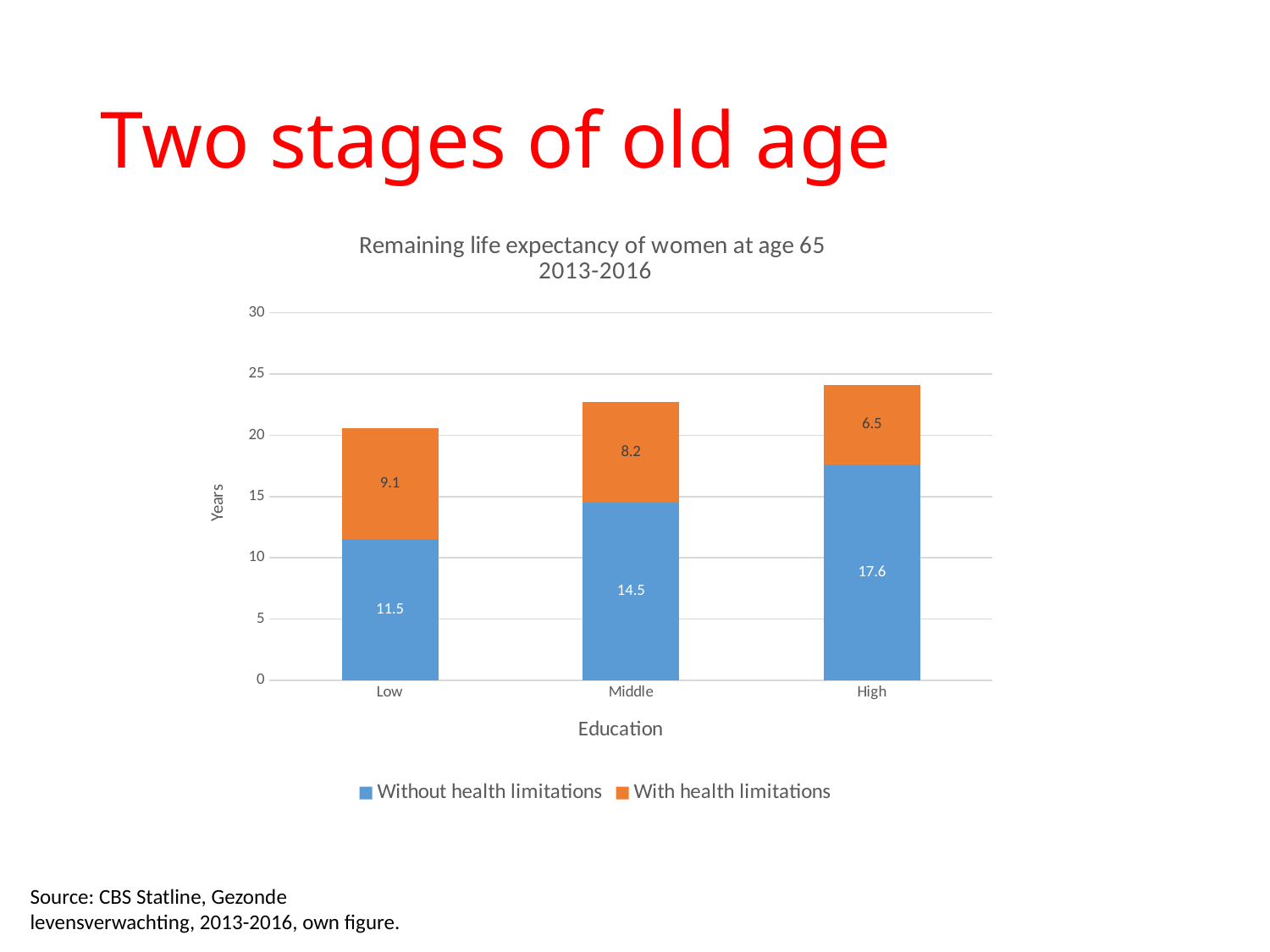
Which education group has the highest value for 'Without health limitations'? High What is the value for 'Without health limitations' for the Low education group? 11.5 What is the difference between the 'Without health limitations' values for High and Low education? 6.1 What is the value for 'With health limitations' for the Middle education group? 8.2 How many education categories are shown on the x axis? 3 What is the value for 'With health limitations' for the High education group? 6.5 Which is larger: 'With health limitations' for Low education or for Middle education? Low Which education group has the lowest value for 'With health limitations'? High What kind of chart is shown on the slide? Stacked bar chart How many series does the legend list? 2 What is the total remaining life expectancy for the Middle education group? 22.7 What is the total remaining life expectancy for the High education group? 24.1